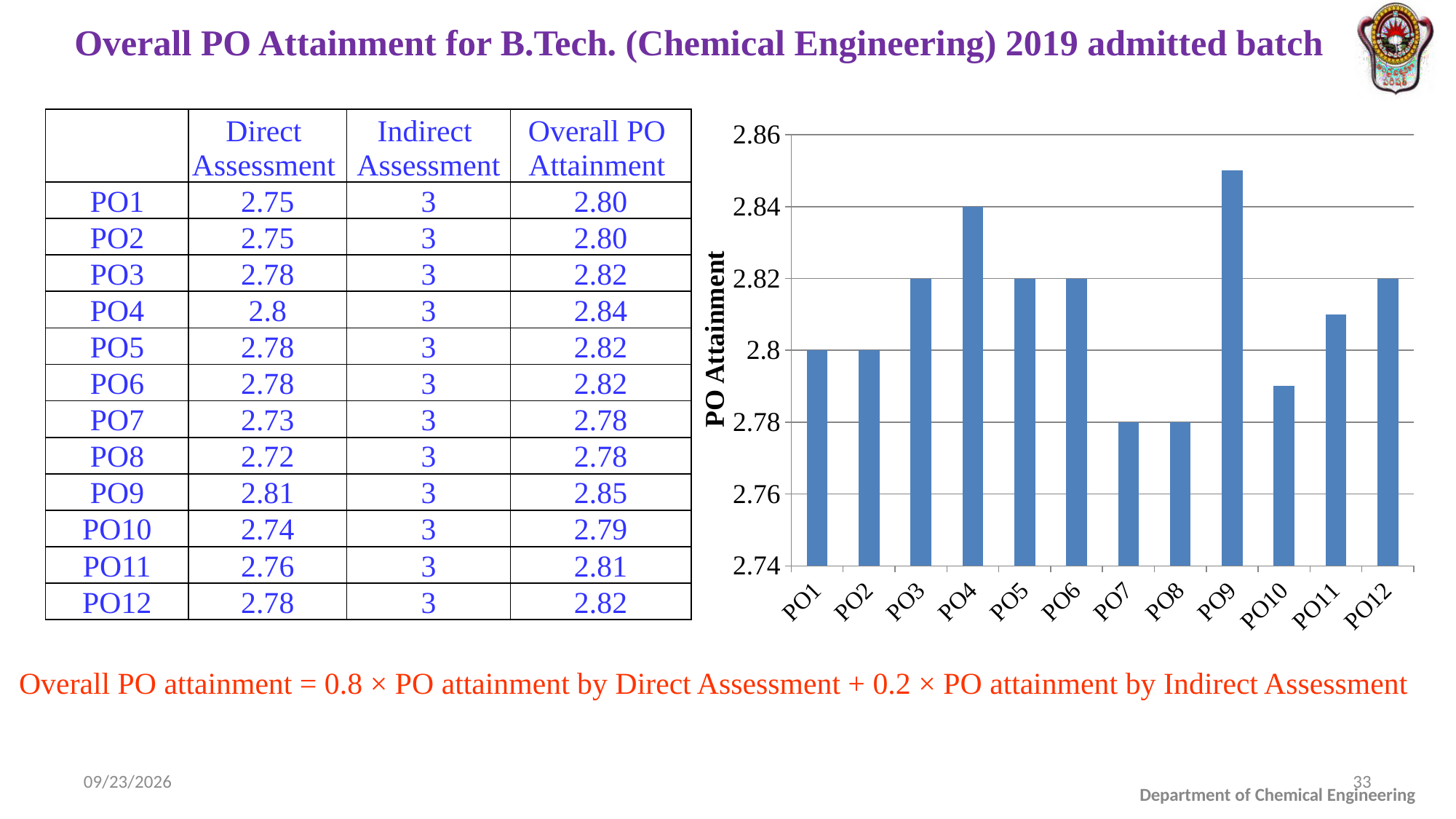
What is the PO Attainment value for PO4 in the chart? 2.84 What is the PO Attainment value for PO1 in the chart? 2.80 Which is larger in the chart, the PO Attainment for PO4 or for PO7? PO4 What is the label on the vertical axis of the chart? PO Attainment What is the difference between the PO Attainment for PO9 and for PO8? 0.07 What is the lowest value shown on the vertical axis of the chart? 2.74 Is the PO Attainment value for PO10 greater or less than 2.80? less Which PO has the highest PO Attainment in the chart? PO9 What kind of chart is shown on the slide? bar chart How many PO categories are plotted on the x axis of the chart? 12 Is the PO Attainment value for PO11 greater or less than 2.80? greater What is the PO Attainment value for PO9 in the chart? 2.85